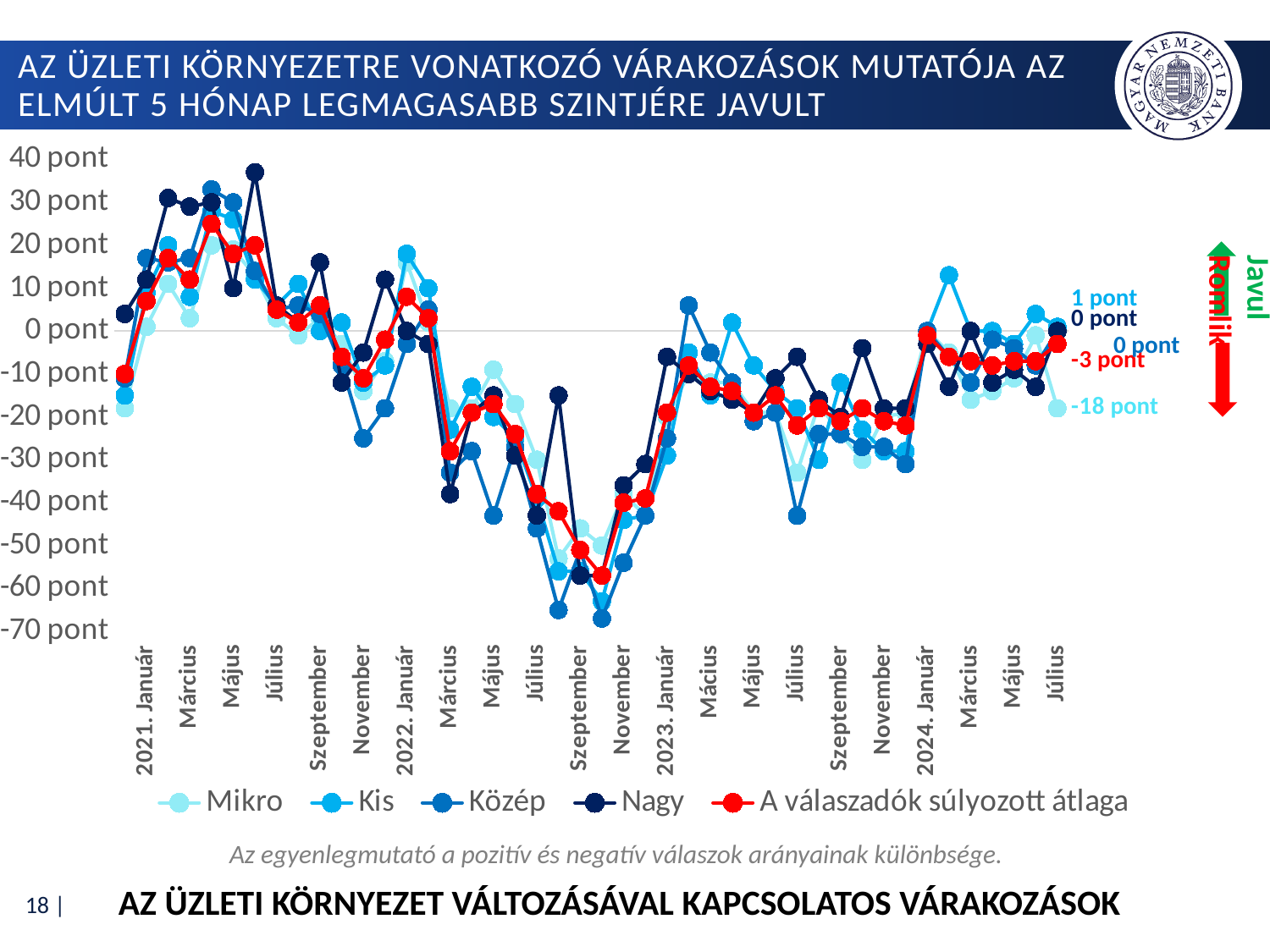
Is the highest value reached by the Nagy series greater or less than 30 pont? greater What is the difference between the latest values of the Kis series and the Mikro series? 19 pont What is the latest value shown for the series 'A válaszadók súlyozott átlaga'? -3 pont What is the latest value shown for the Kis series? 1 pont Which series has the lowest value at the end of the chart (2024 July)? Mikro Which series has the highest value at the end of the chart (2024 July)? Kis Is the lowest value reached by the 'A válaszadók súlyozott átlaga' series greater or less than -50 pont? less At the end of the chart, which is larger: the value of 'A válaszadók súlyozott átlaga' or the value of Mikro? A válaszadók súlyozott átlaga What kind of chart is shown on the slide? line chart Between 2022 January and 2022 November, does the 'A válaszadók súlyozott átlaga' series rise or fall? fall What is the latest value shown for the Mikro series? -18 pont How many series does the legend list? 5